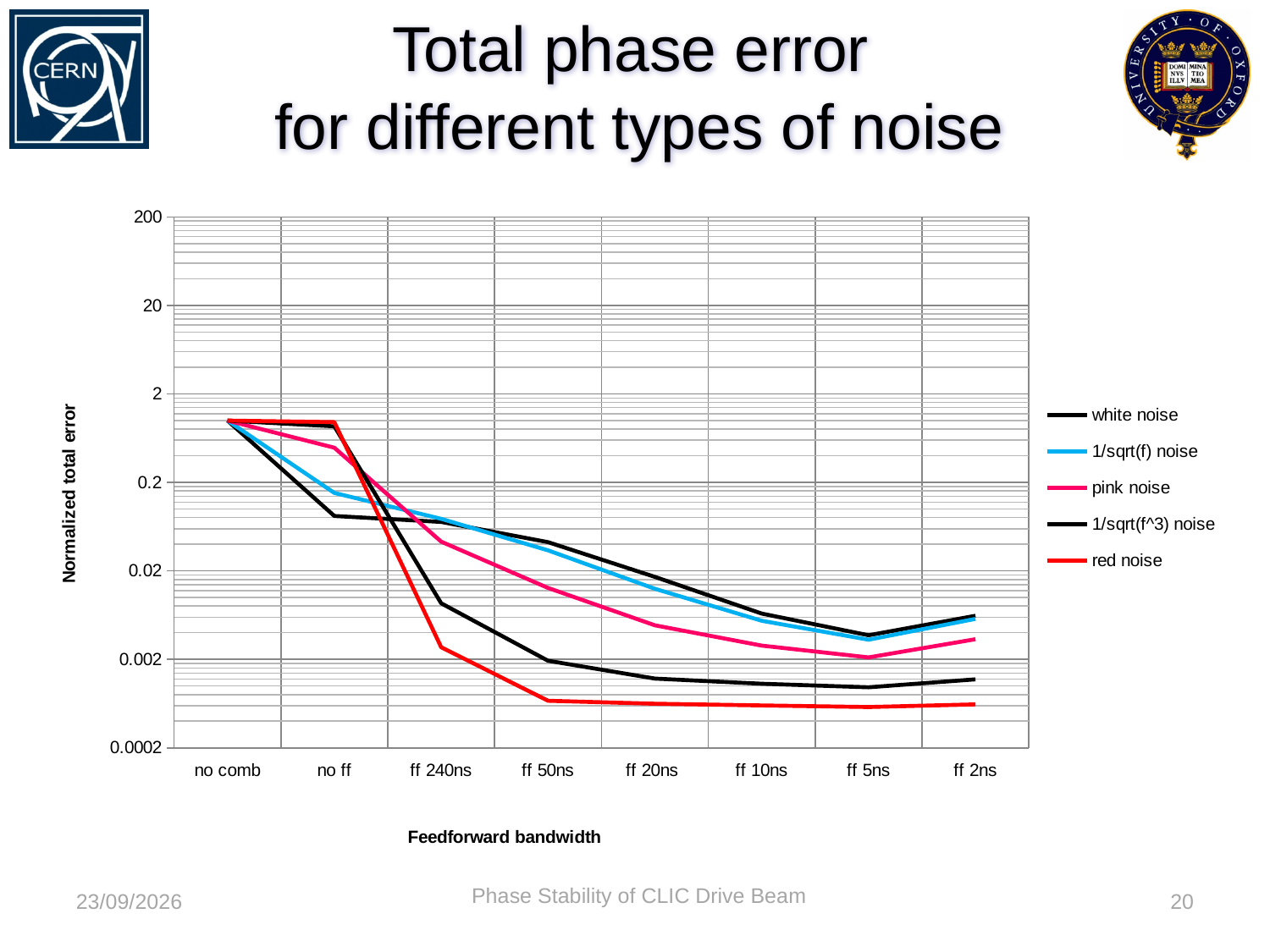
Is the value for red noise at ff 50ns greater or less than 0.002? less At ff 10ns, which is larger: 1/sqrt(f) noise or pink noise? 1/sqrt(f) noise Is the value for 1/sqrt(f) noise at ff 5ns greater or less than 0.002? greater What kind of chart is shown on the slide? line chart Does the red noise series rise or fall from no comb to ff 5ns? fall Which series has the lowest value at ff 2ns? red noise Is the value for 1/sqrt(f) noise at ff 240ns greater or less than 0.2? less Which series has the lowest value at ff 50ns? red noise How many series does the legend list? 5 How many categories are shown on the x axis? 8 At ff 20ns, which is larger: pink noise or red noise? pink noise